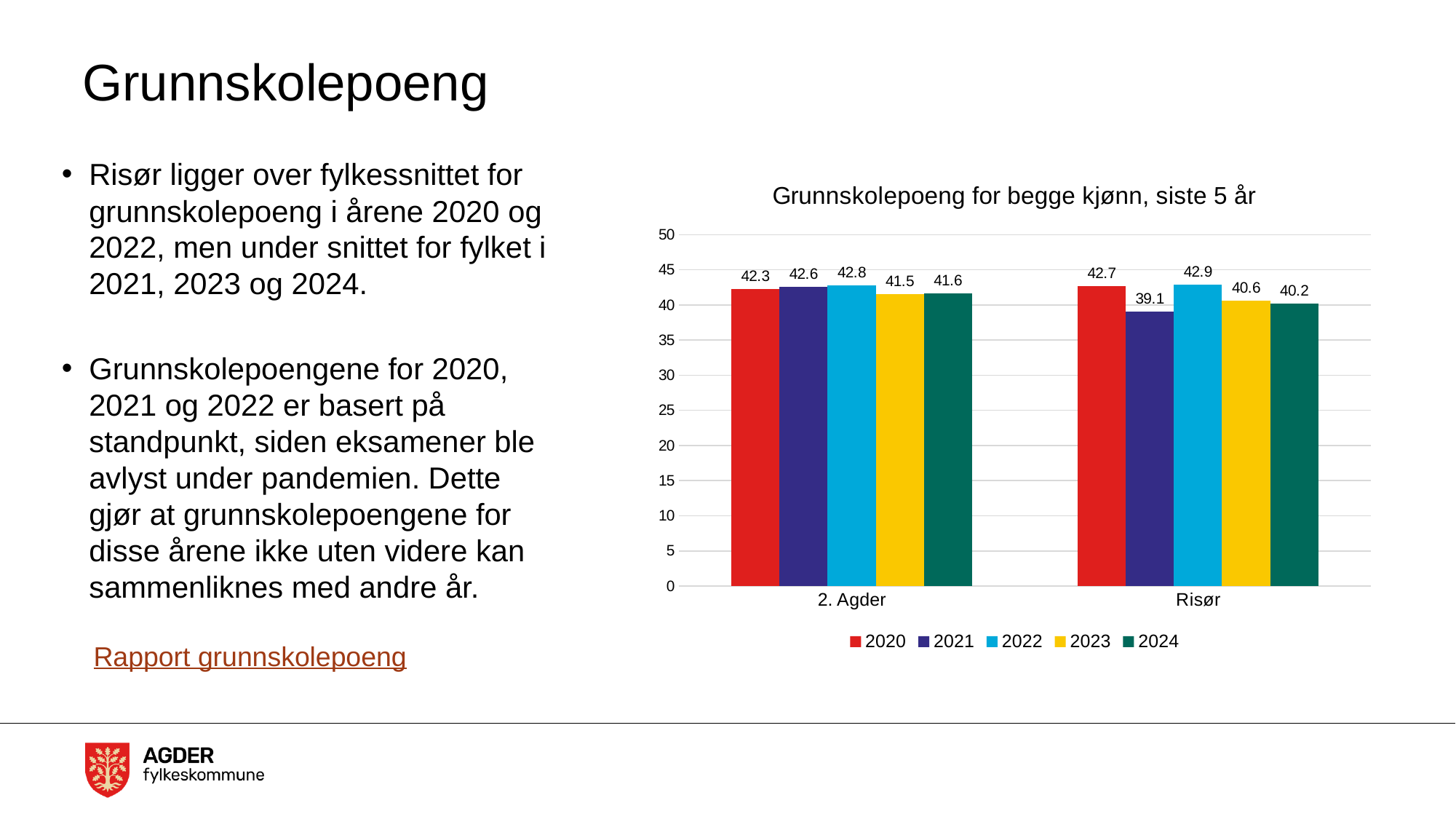
Is the value for Risør in 2020 greater or less than 40? greater How many series does the legend list? 5 What is the value for Risør in 2021? 39.1 Which year has the lowest value for Risør? 2021 Which is larger, the 2023 value for 2. Agder or for Risør? 2. Agder What is the value for 2. Agder in 2022? 42.8 What is the difference between the 2. Agder and Risør values for 2021? 3.5 What is the title of the chart? Grunnskolepoeng for begge kjønn, siste 5 år What kind of chart is shown on the slide? Bar chart Which year has the highest value for 2. Agder? 2022 How many categories are shown on the x axis? 2 What is the value for Risør in 2024? 40.2